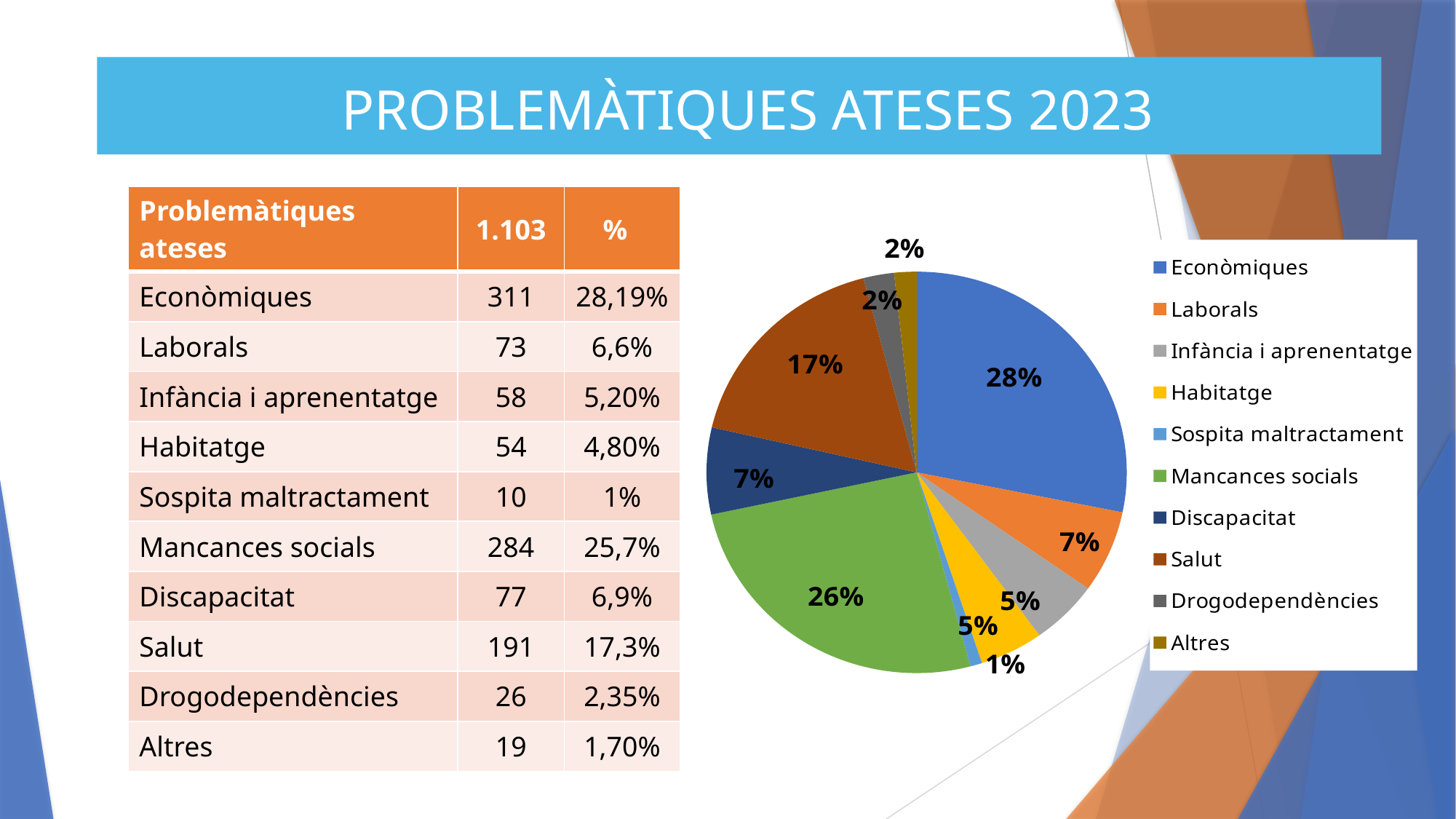
In the pie chart, which slice is larger: Salut or Laborals? Salut What type of chart is shown on the slide? pie chart In the pie chart, what percentage is shown for Salut? 17% In the pie chart, what is the difference in percentage points between Econòmiques and Mancances socials? 2 How many categories does the pie chart legend list? 10 In the pie chart, what percentage is shown for Sospita maltractament? 1% In the pie chart, what percentage is shown for Drogodependències? 2% Which category has the largest slice in the pie chart? Econòmiques Which category has the smallest slice in the pie chart? Sospita maltractament In the pie chart, what percentage is shown for Mancances socials? 26% What colour is the Mancances socials slice in the pie chart? green In the pie chart, what percentage is shown for Econòmiques? 28%